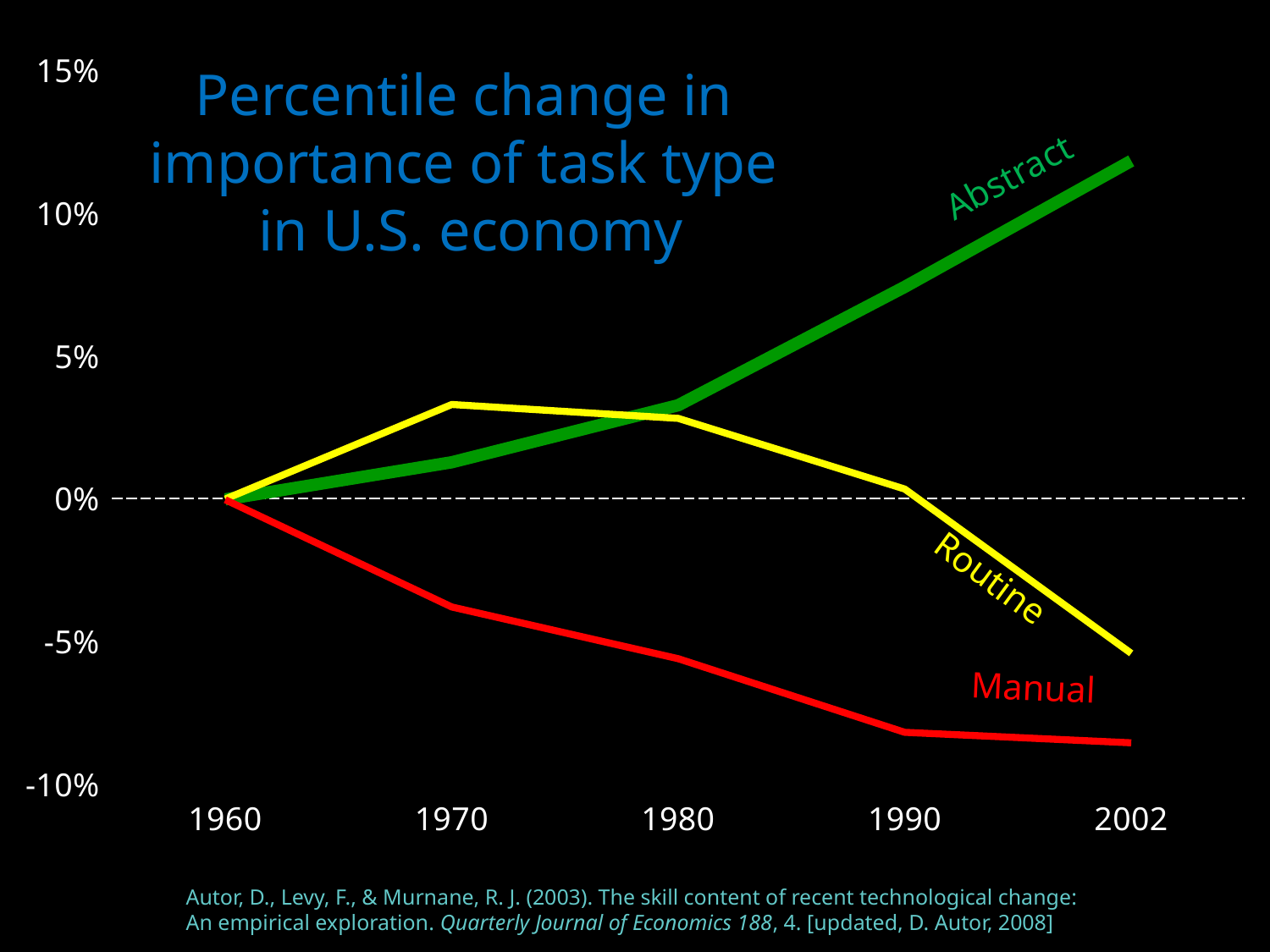
Does the Manual line rise or fall from 1960 to 2002? fall Is the value for Routine in 1970 greater or less than 0%? greater How many task-type series are plotted on the chart? 3 Which series has the lowest value in 2002? Manual Is the value for Manual in 1990 greater or less than -5%? less What is the value of the Abstract line in 1960? 0% What colour is the Routine line? yellow What kind of chart is shown on the slide? line chart Which series has the highest value in 2002? Abstract In 1970, which is higher, the Routine line or the Abstract line? Routine Is the value for Abstract in 2002 greater or less than 10%? greater How many years are marked on the x axis of the chart? 5